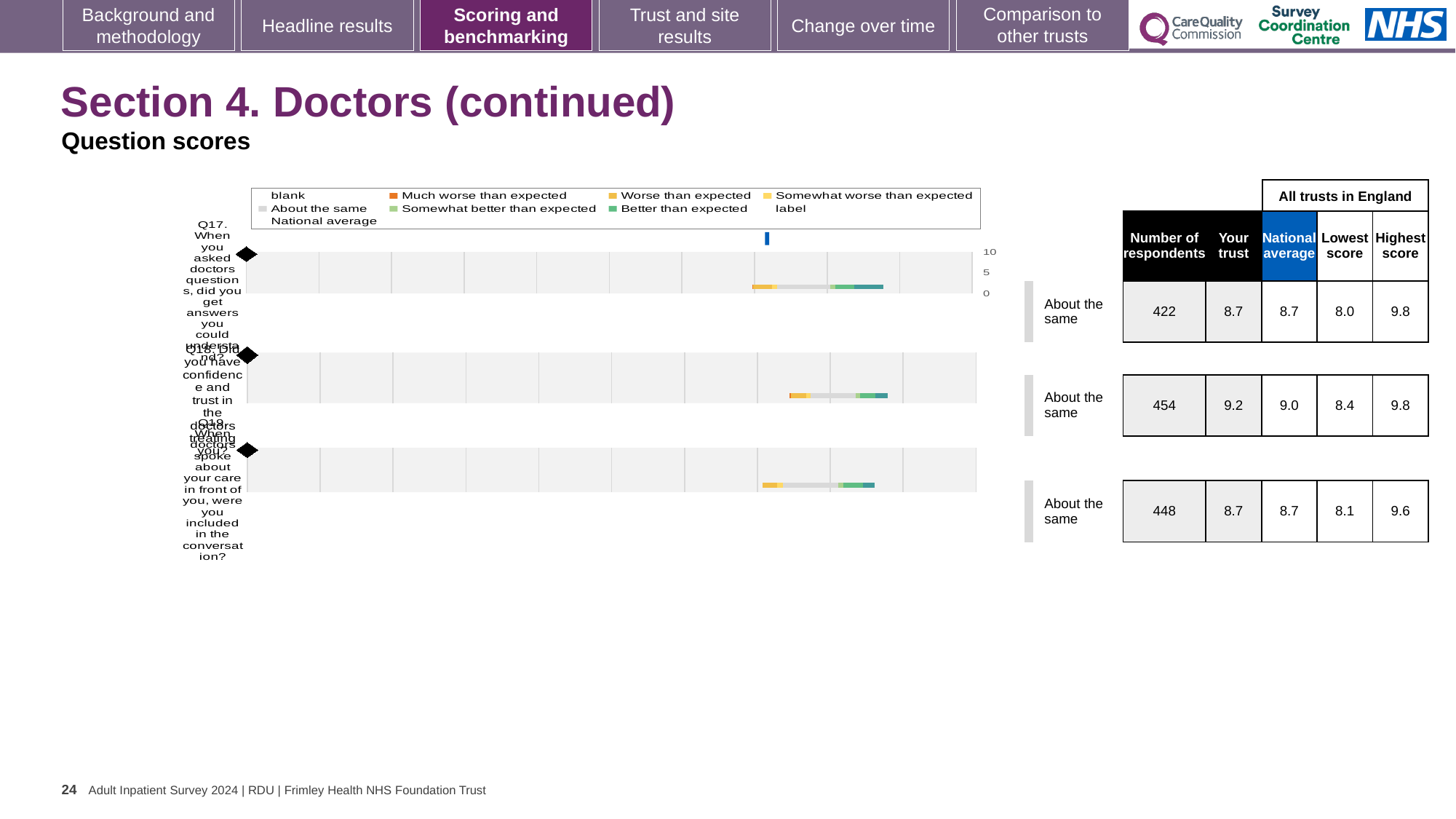
What is the number of respondents for Q17? 422 What is the highest score across all trusts in England for Q19? 9.6 What benchmark label is shown next to the bar for Q18? About the same What is the 'Your trust' score for Q18? 9.2 What is the national average score for Q18? 9.0 How many entries does the chart legend list? 9 Which question has the highest number of respondents? Q18 What colour does the legend use for 'Much worse than expected'? Orange What is the difference between the highest score and the lowest score for Q18? 1.4 What kind of chart is used to show the question scores for Q17, Q18 and Q19? Bar chart How many questions (bars) are plotted in the chart? 3 For Q18, which is larger: the 'Your trust' score or the national average? Your trust